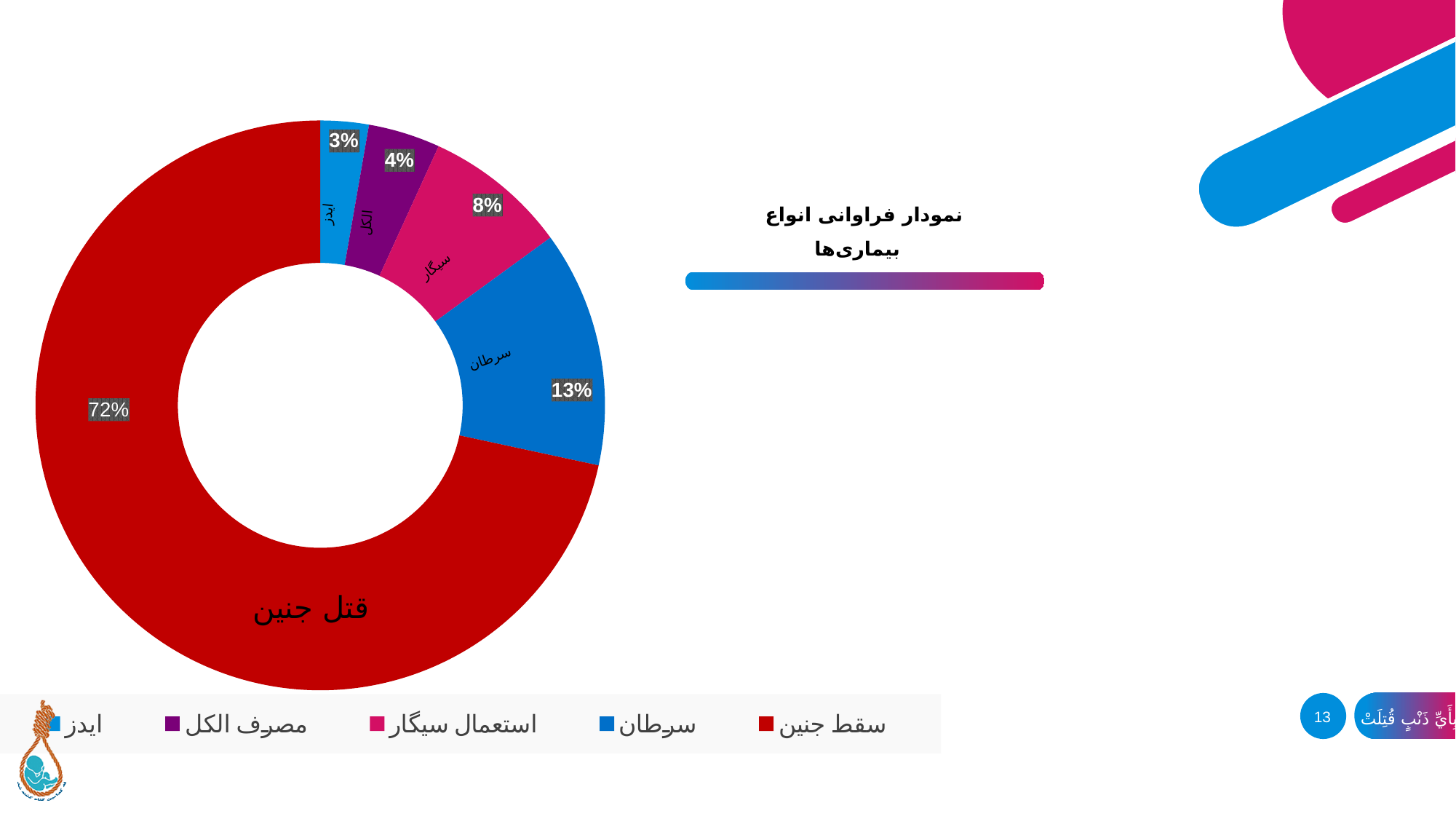
What is the value for سقط جنین? 72% What colour is the slice for سرطان? Blue What is the difference between the values for سقط جنین and سرطان? 59% What is the value for سرطان? 13% What is the value for ایدز? 3% Which category has the largest share of the chart? سقط جنین What kind of chart is shown on the slide? Donut (pie) chart What is the value for مصرف الکل? 4% Which category has the smallest share of the chart? ایدز What is the value for استعمال سیگار? 8% How many categories does the chart show? 5 Which is larger, the value for استعمال سیگار or the value for مصرف الکل? استعمال سیگار